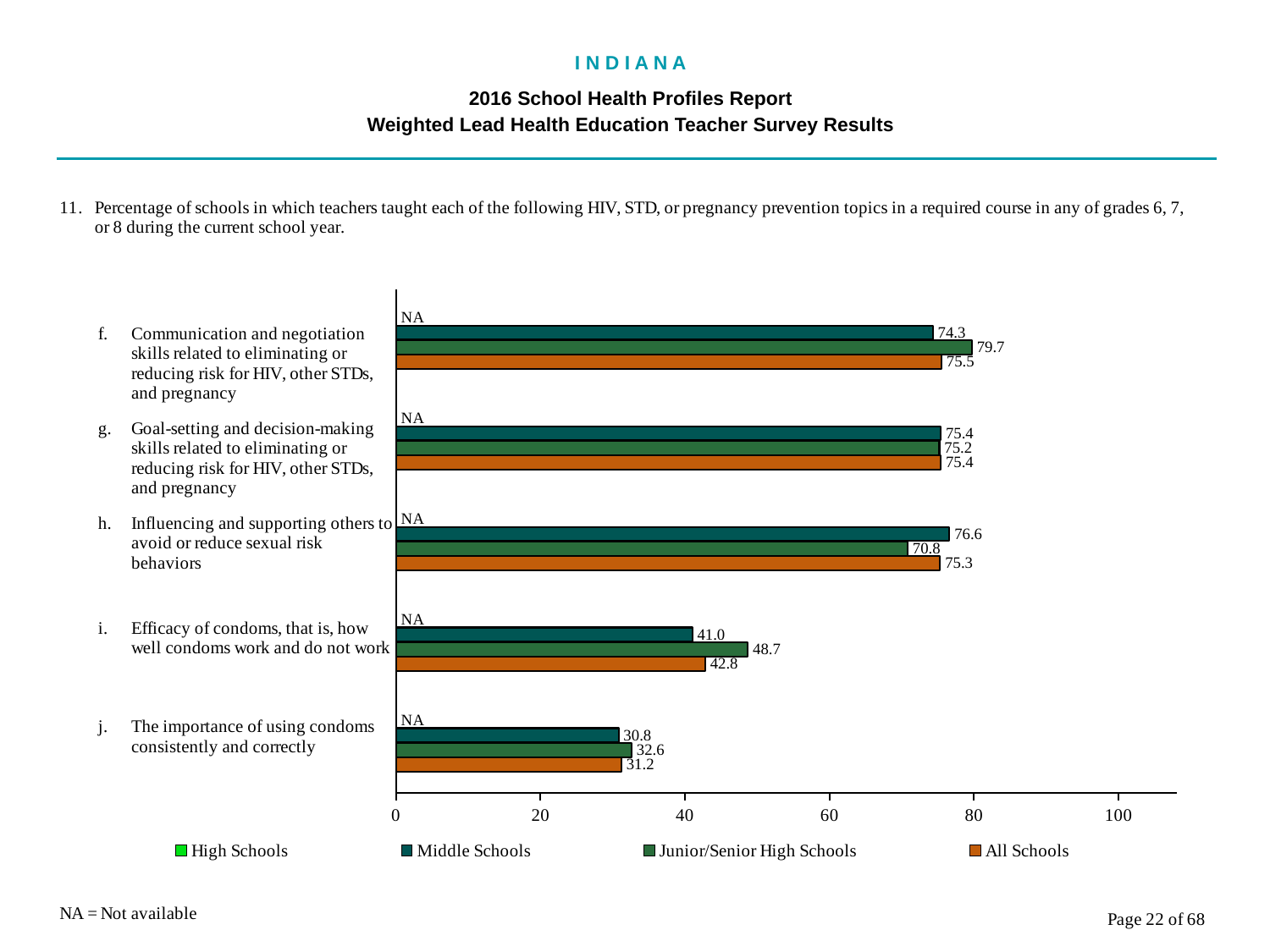
What is the value for Middle Schools for topic f, communication and negotiation skills related to eliminating or reducing risk for HIV, other STDs, and pregnancy? 74.3 What is the difference between the Junior/Senior High Schools and Middle Schools values for topic i, efficacy of condoms? 7.7 What value is shown for High Schools for every topic on the chart? NA How many topics are plotted on the chart? 5 How many series does the legend list? 4 Is the All Schools value for topic i, efficacy of condoms, greater or less than 40? greater Which topic has the highest Junior/Senior High Schools value? f. Communication and negotiation skills related to eliminating or reducing risk for HIV, other STDs, and pregnancy For topic h, influencing and supporting others to avoid or reduce sexual risk behaviors, which is larger: the Middle Schools value or the Junior/Senior High Schools value? Middle Schools Which topic has the lowest All Schools value? j. The importance of using condoms consistently and correctly What is the All Schools value for topic j, the importance of using condoms consistently and correctly? 31.2 What is the value for Junior/Senior High Schools for topic i, efficacy of condoms? 48.7 What kind of chart is shown on the slide? Bar chart